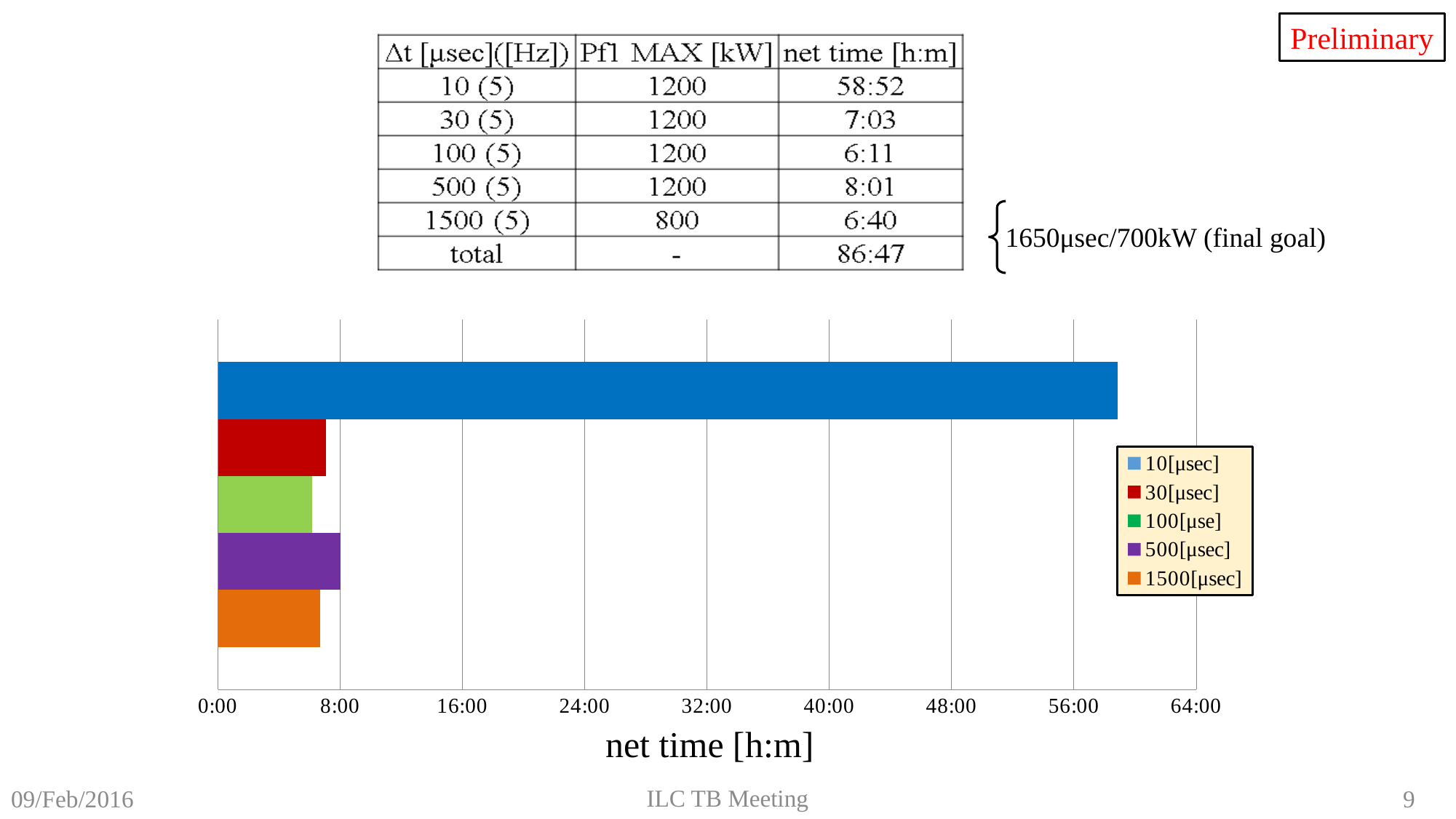
Is the value for 1500[μsec] greater or less than 8:00? less How many bars are plotted in the chart? 5 Is the value for 100[μse] greater or less than 8:00? less How many series does the chart legend list? 5 Is the value for 30[μsec] greater or less than 8:00? less Which is larger, the value for 500[μsec] or the value for 30[μsec]? 500[μsec] Which series has the longest bar in the chart? 10[μsec] What is the title of the chart's horizontal axis? net time [h:m] What kind of chart is shown on the slide? bar chart Which is larger, the value for 10[μsec] or the value for 1500[μsec]? 10[μsec] What colour is the bar for the 1500[μsec] series? orange